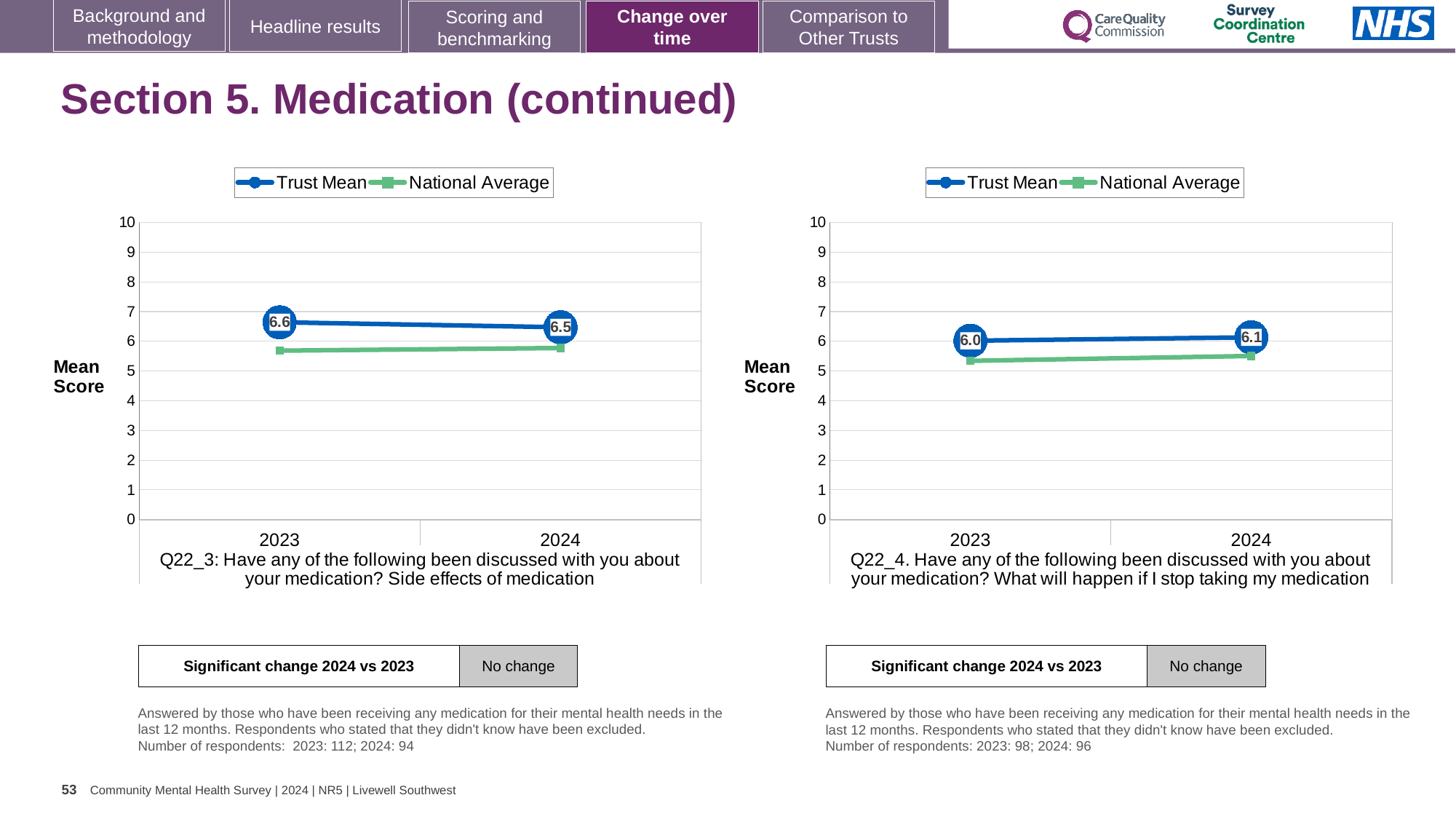
On the left chart (Q22_3), what is the difference between the Trust Mean scores for 2023 and 2024? 0.1 On the right chart (Q22_4), what is the Trust Mean score for 2024? 6.1 On the right chart (Q22_4), which year has the higher Trust Mean score, 2023 or 2024? 2024 On the left chart (Q22_3), is the National Average value for 2023 greater or less than 6? less On the right chart (Q22_4), is the National Average value for 2024 greater or less than 6? less On the right chart (Q22_4), how many years are plotted on the x axis? 2 On the right chart (Q22_4), how many series does the legend list? 2 On the right chart (Q22_4), what is the Trust Mean score for 2023? 6.0 On the left chart (Q22_3), what is the Trust Mean score for 2023? 6.6 On the left chart (Q22_3), does the Trust Mean rise or fall from 2023 to 2024? fall What kind of chart is the left chart (Q22_3)? line chart On the left chart (Q22_3), what is the Trust Mean score for 2024? 6.5